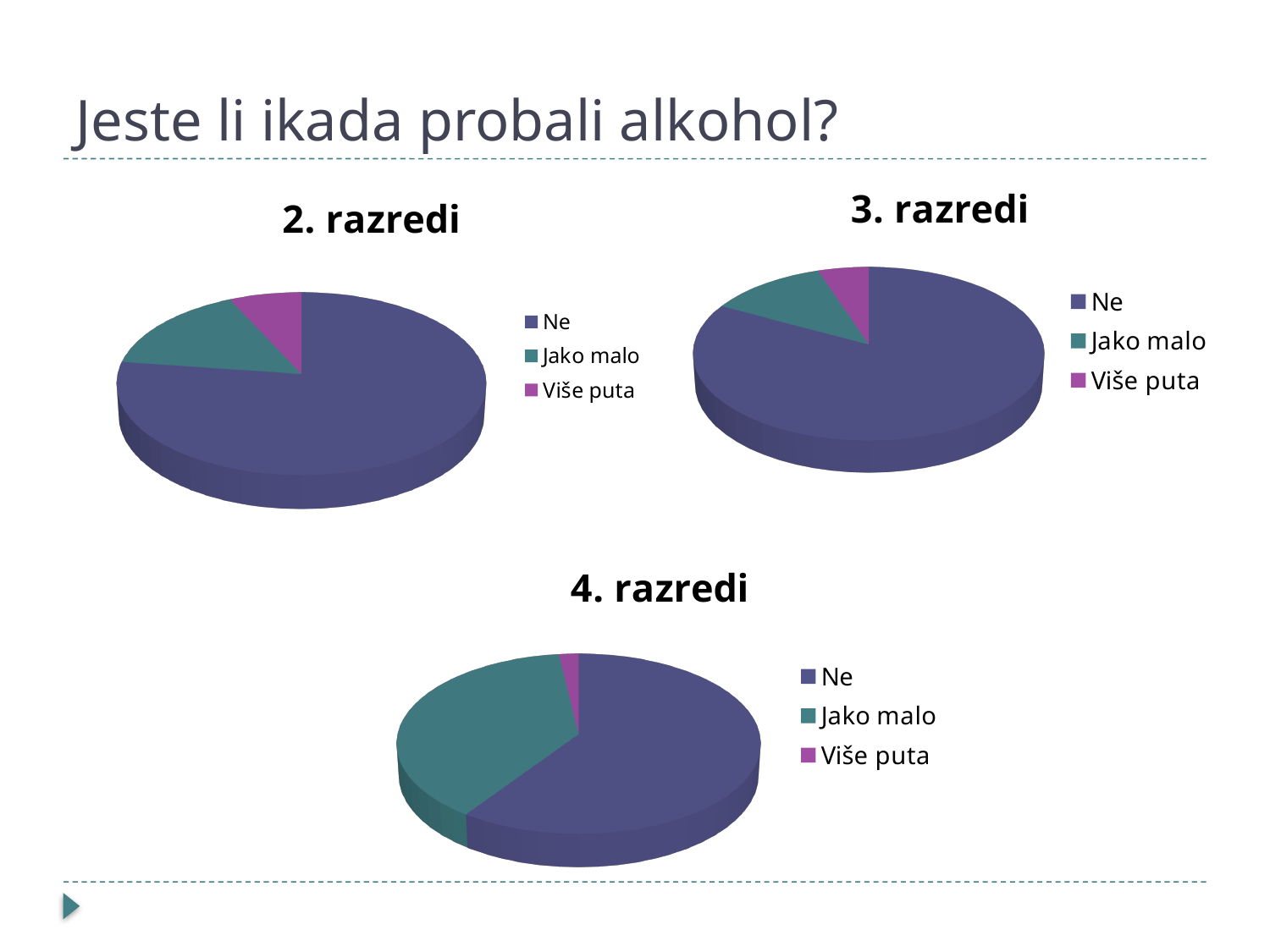
How many pie charts are shown on the slide? 3 What kind of chart is the "2. razredi" chart? pie chart How many slices does the "3. razredi" pie chart have? 3 In the "2. razredi" chart, which category has the smallest slice? Više puta What is the title of the slide? Jeste li ikada probali alkohol? In the "3. razredi" chart, which category has the largest slice? Ne In the "4. razredi" chart, which category has the smallest slice? Više puta In the "3. razredi" chart, which slice is larger: "Jako malo" or "Više puta"? Jako malo In the "4. razredi" chart, which slice is larger: "Ne" or "Jako malo"? Ne What are the legend entries of the "2. razredi" chart? Ne, Jako malo, Više puta In the "2. razredi" chart, which category has the largest slice? Ne How many entries does the legend of the "4. razredi" chart list? 3